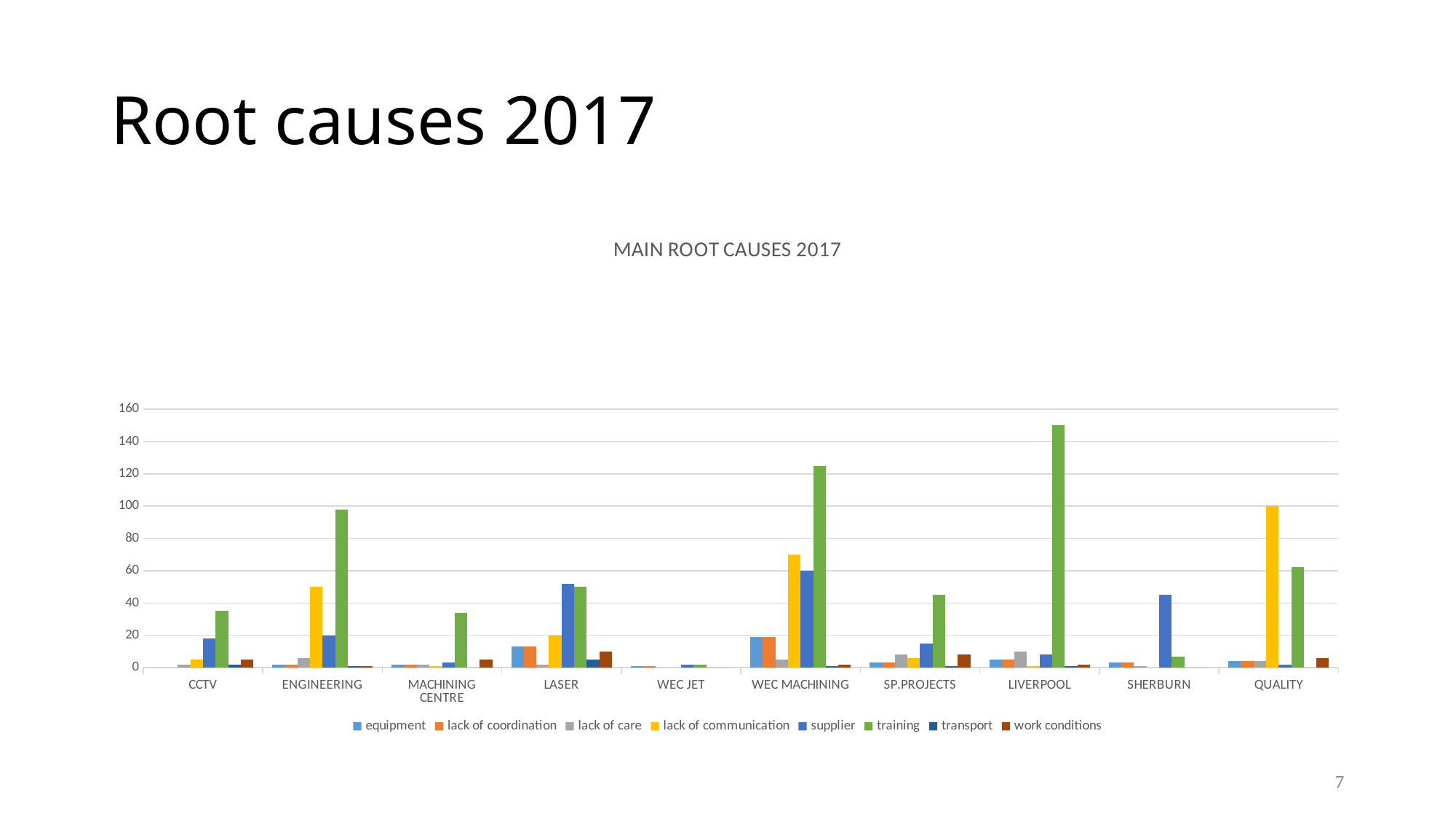
How many series does the legend list? 8 Which is larger, the lack of communication value for QUALITY or for WEC MACHINING? QUALITY Which is larger, the training value for ENGINEERING or for QUALITY? ENGINEERING What kind of chart is shown on the slide? bar chart How many categories are shown on the x axis? 10 Is the value for training at CCTV greater or less than 40? less Is the value for training at LIVERPOOL greater or less than 140? greater Which category has the highest value for lack of communication? QUALITY Is the value for training at WEC MACHINING greater or less than 100? greater What is the title of the chart? MAIN ROOT CAUSES 2017 Which category has the highest value for training? LIVERPOOL